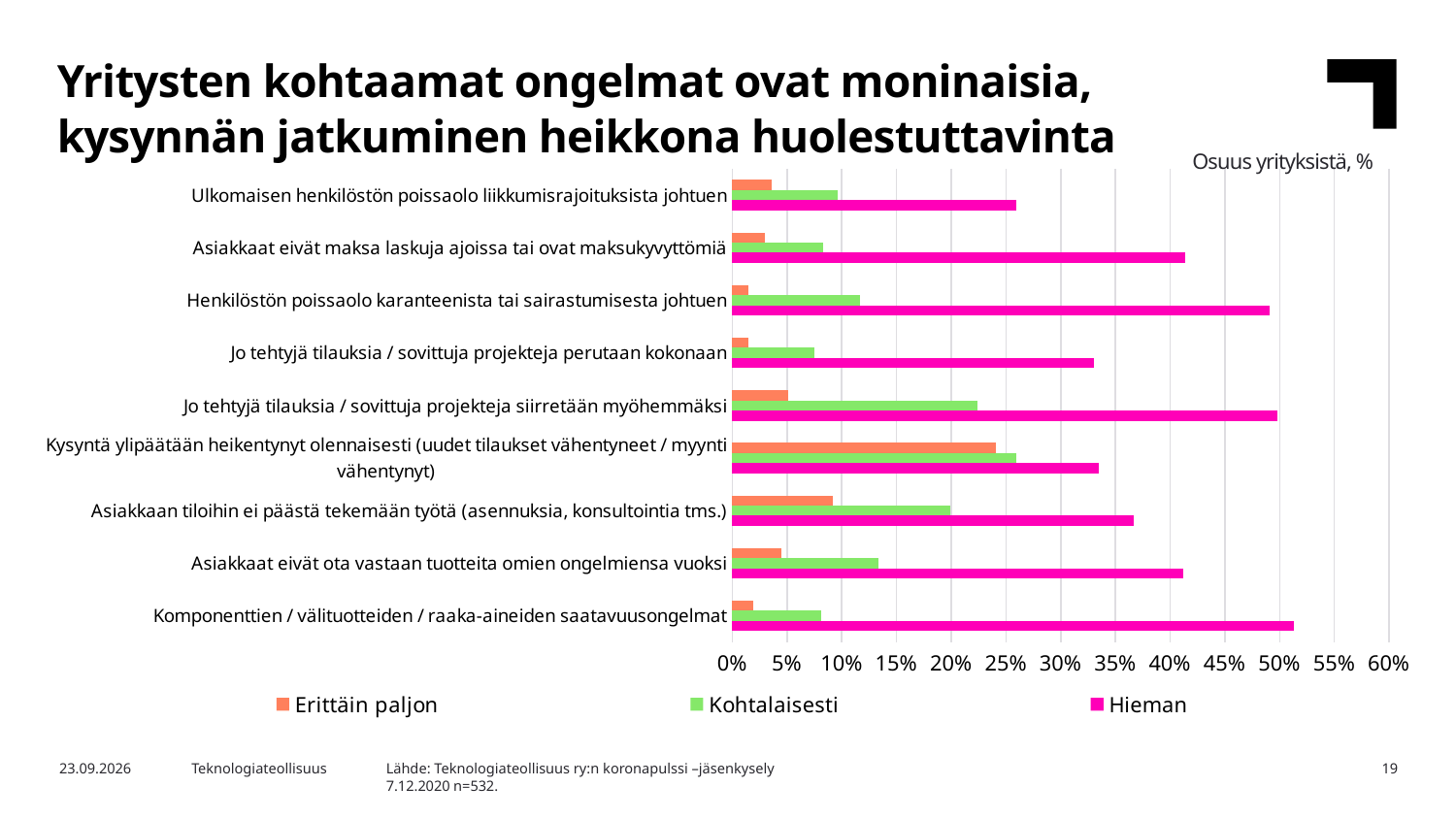
What kind of chart is shown on the slide? Bar chart Is the 'Hieman' value for 'Henkilöstön poissaolo karanteenista tai sairastumisesta johtuen' greater or less than 45%? greater Is the 'Hieman' value for 'Ulkomaisen henkilöstön poissaolo liikkumisrajoituksista johtuen' greater or less than 30%? less Which category has the highest value for the 'Kohtalaisesti' series? Kysyntä ylipäätään heikentynyt olennaisesti (uudet tilaukset vähentyneet / myynti vähentynyt) Is the 'Erittäin paljon' value for 'Kysyntä ylipäätään heikentynyt olennaisesti' greater or less than 20%? greater How many categories (problem types) are plotted on the chart? 9 Which is larger: the 'Kohtalaisesti' value for 'Jo tehtyjä tilauksia / sovittuja projekteja siirretään myöhemmäksi' or for 'Jo tehtyjä tilauksia / sovittuja projekteja perutaan kokonaan'? Jo tehtyjä tilauksia / sovittuja projekteja siirretään myöhemmäksi What are the three series names listed in the chart legend? Erittäin paljon, Kohtalaisesti, Hieman Which is larger: the 'Hieman' value for 'Asiakkaat eivät maksa laskuja ajoissa tai ovat maksukyvyttömiä' or the 'Hieman' value for 'Jo tehtyjä tilauksia / sovittuja projekteja perutaan kokonaan'? Asiakkaat eivät maksa laskuja ajoissa tai ovat maksukyvyttömiä Which category has the lowest value for the 'Hieman' series? Ulkomaisen henkilöstön poissaolo liikkumisrajoituksista johtuen Which category has the highest value for the 'Erittäin paljon' series? Kysyntä ylipäätään heikentynyt olennaisesti (uudet tilaukset vähentyneet / myynti vähentynyt) How many series does the legend list? 3